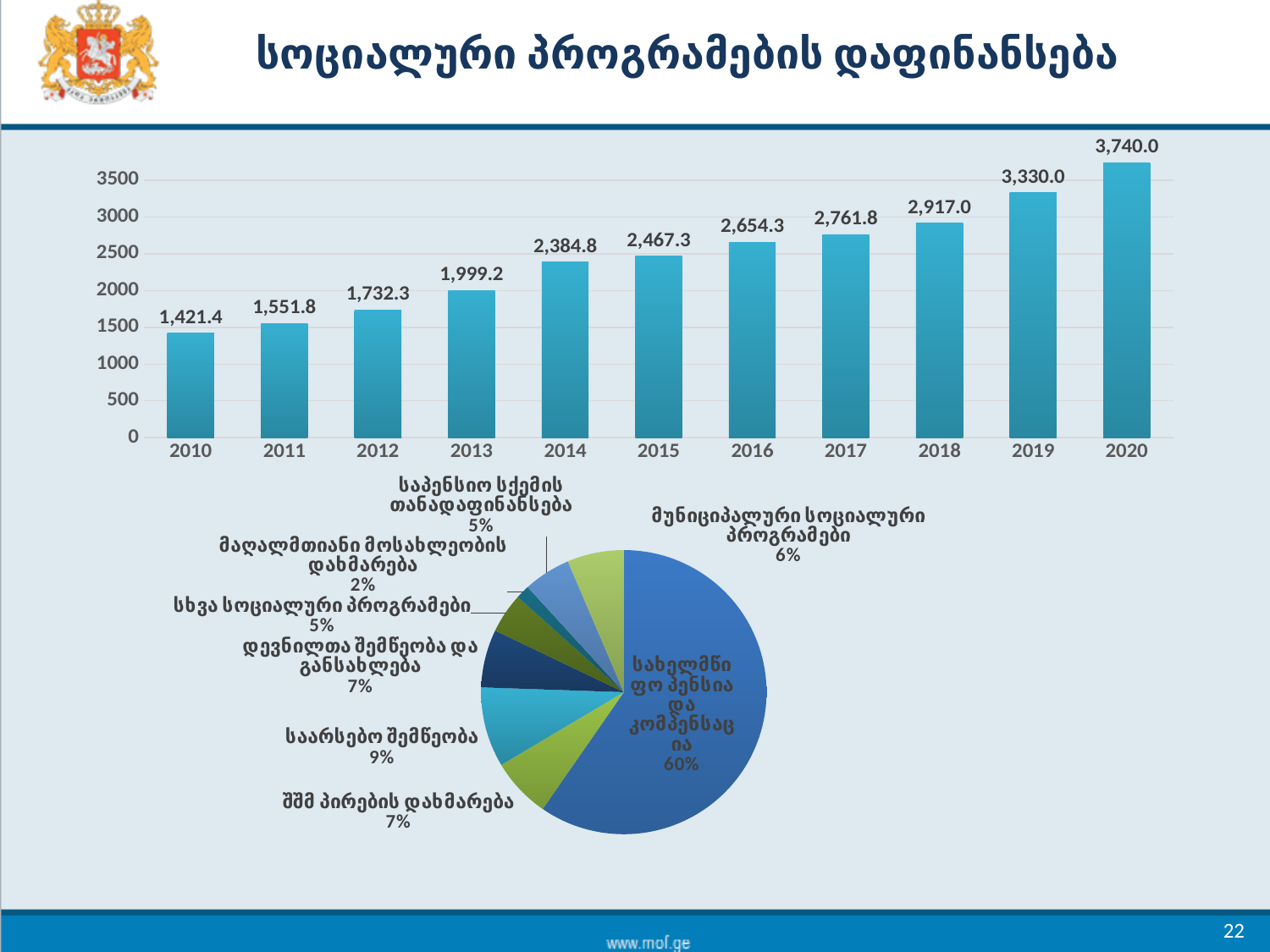
In the top bar chart, do the values rise or fall from 2010 to 2020? rise In the top bar chart, what is the difference between the values for 2020 and 2010? 2,318.6 In the bottom pie chart, what share does საარსებო შემწეობა have? 9% In the top bar chart, which year has the highest value? 2020 In the bottom pie chart, what share does სახელმწიფო პენსია და კომპენსაცია have? 60% In the bottom pie chart, which slice is the smallest? მაღალმთიანი მოსახლეობის დახმარება What kind of chart is the top chart on the slide? bar chart In the top bar chart, how many years are shown on the x axis? 11 In the top bar chart, what is the value for 2019? 3,330.0 In the top bar chart, what is the value for 2014? 2,384.8 In the top bar chart, which is larger, the value for 2016 or the value for 2017? 2017 In the top bar chart, which year has the lowest value? 2010